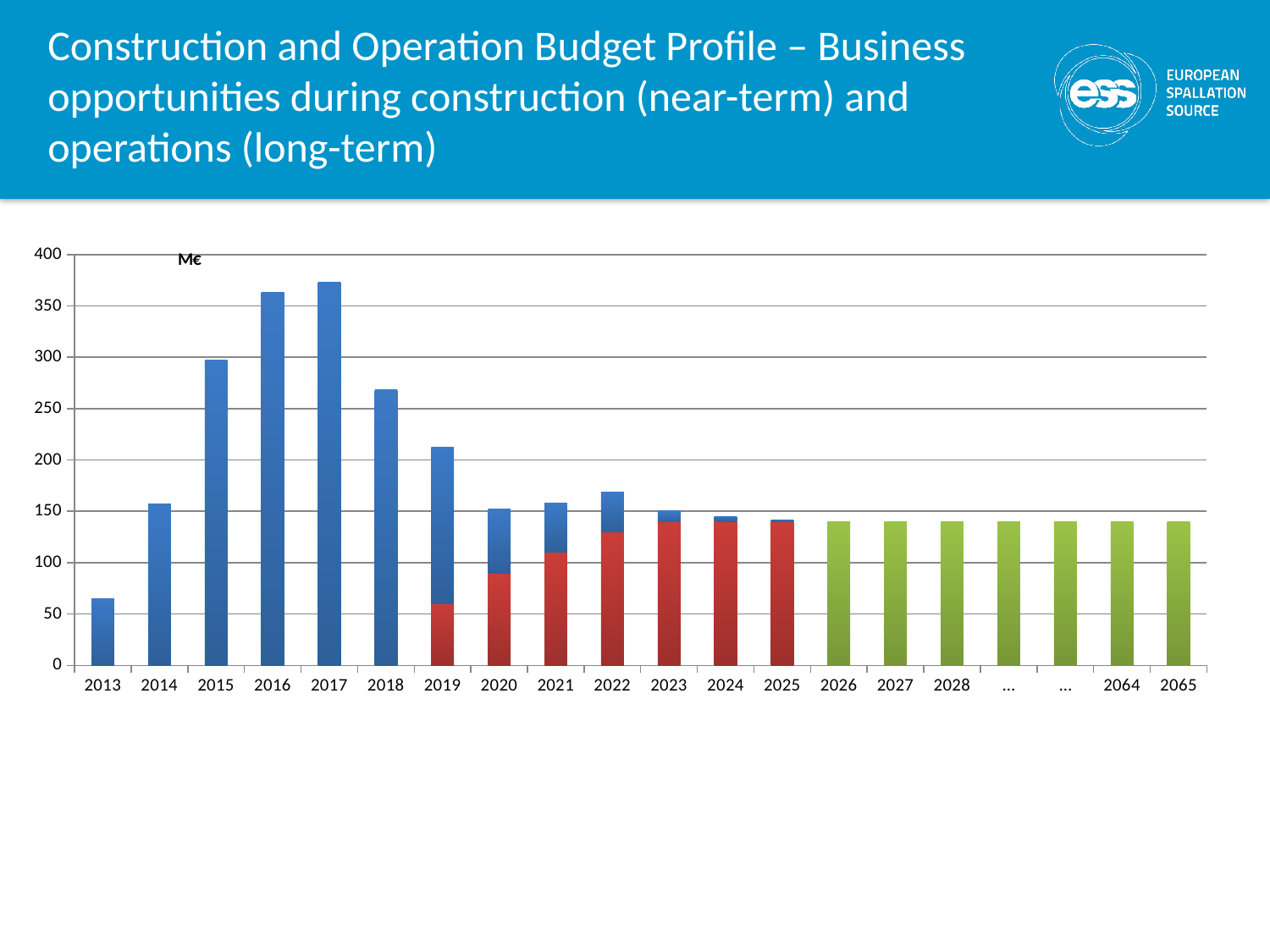
How many categories are shown along the x axis? 20 Do the bar values rise or fall from 2017 to 2025? fall What kind of chart is shown on the slide? stacked bar chart Which year has the tallest bar? 2017 Which is larger, the bar for 2015 or the bar for 2018? 2015 Is the value for 2016 greater or less than 350? greater Is the total value for 2019 greater or less than 200? greater Which year has the shortest bar? 2013 Is the value for 2013 greater or less than 100? less What unit label is shown at the top of the chart? M€